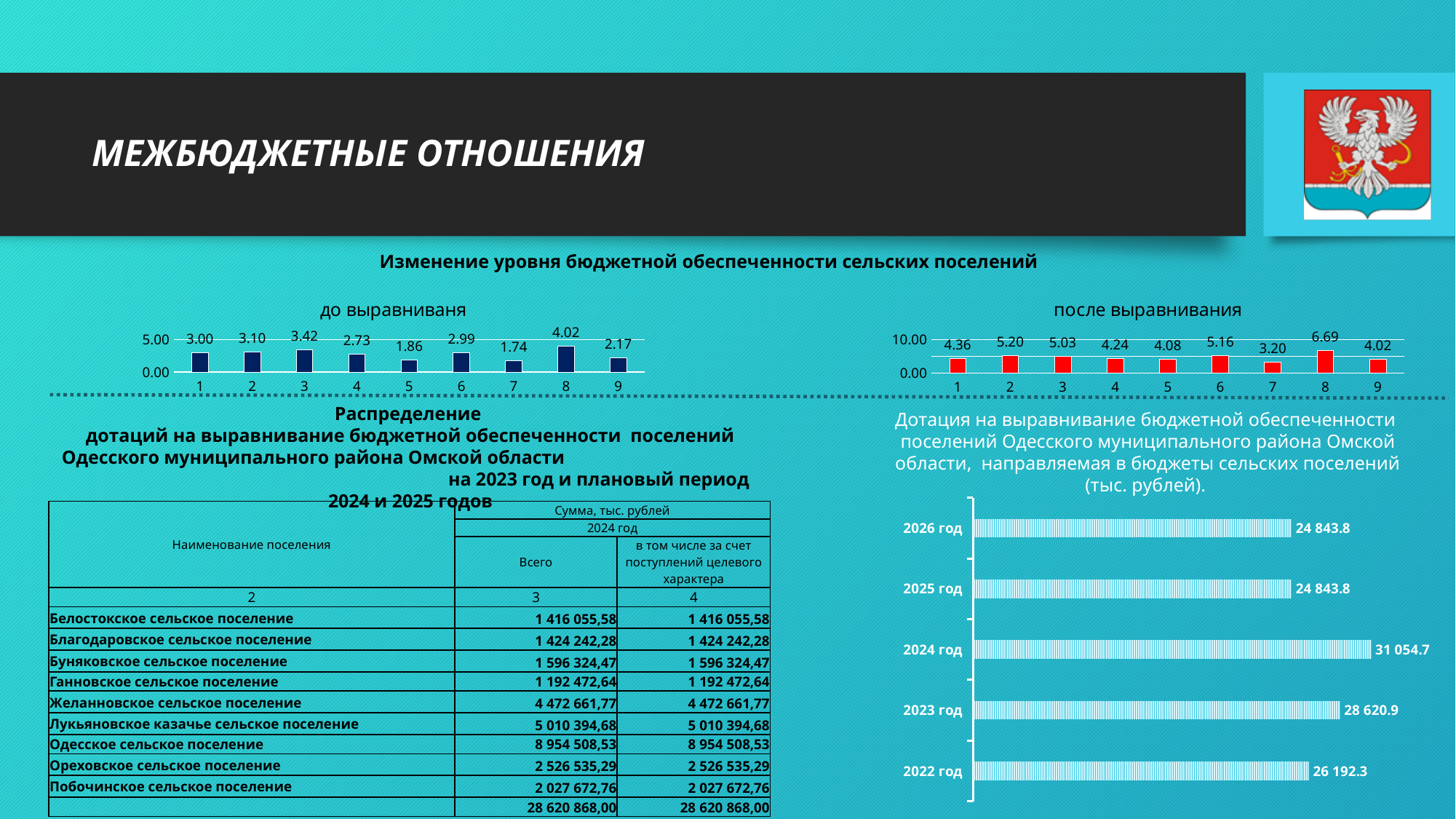
In the chart titled "до выравнивания", how many categories are plotted? 9 In the chart titled "до выравнивания", what is the value for category 8? 4.02 In the chart titled "Дотация на выравнивание бюджетной обеспеченности поселений...", how many years are plotted? 5 In the chart titled "после выравнивания", is the value for category 2 larger than the value for category 5? Yes In the chart titled "после выравнивания", what is the value for category 3? 5.03 In the chart titled "до выравнивания", which category has the lowest value? 7 In the chart titled "после выравнивания", what is the difference between the values for category 8 and category 7? 3.49 In the chart titled "Дотация на выравнивание бюджетной обеспеченности поселений...", which year has the highest value? 2024 год In the chart titled "после выравнивания", which category has the highest value? 8 What kind of chart is the chart titled "до выравнивания"? Bar chart In the chart titled "Дотация на выравнивание бюджетной обеспеченности поселений...", what is the difference between the values for 2023 год and 2022 год? 2 428.6 In the chart titled "Дотация на выравнивание бюджетной обеспеченности поселений...", what is the value for 2024 год? 31 054.7